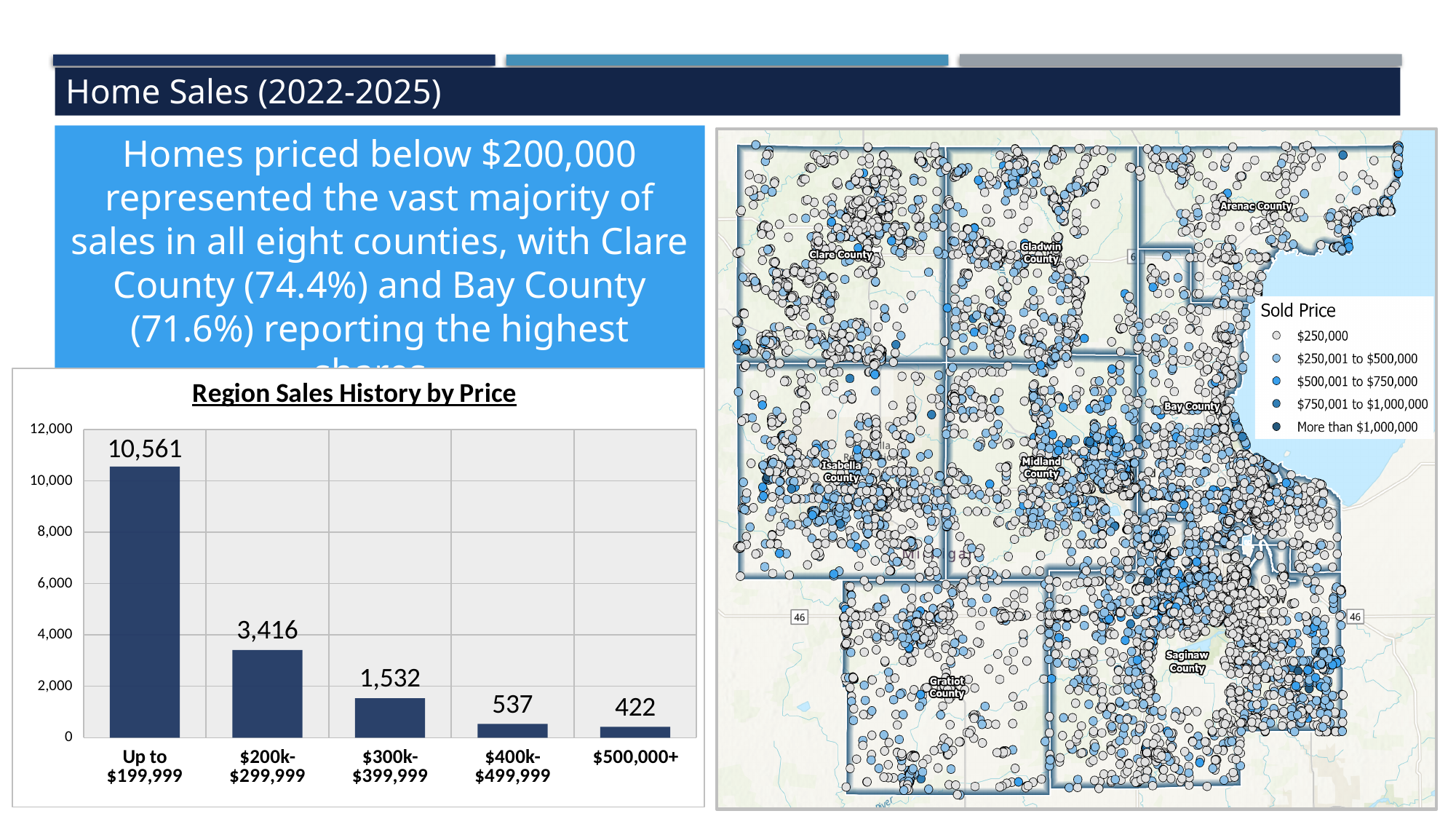
In the Region Sales History by Price chart, what is the value for the $300k-$399,999 range? 1,532 In the Region Sales History by Price chart, how many sales were in the $200k-$299,999 range? 3,416 In the Region Sales History by Price chart, which price range has the lowest number of sales? $500,000+ In the Region Sales History by Price chart, what is the difference between the $400k-$499,999 and $500,000+ values? 115 In the Region Sales History by Price chart, what is the value for the $500,000+ range? 422 In the Region Sales History by Price chart, how many sales were in the Up to $199,999 price range? 10,561 In the Region Sales History by Price chart, what is the difference between the Up to $199,999 and $200k-$299,999 values? 7,145 What type of chart is the Region Sales History by Price chart? Bar chart In the Region Sales History by Price chart, do the values rise or fall as the price ranges increase from left to right? Fall In the Region Sales History by Price chart, which is larger: $300k-$399,999 or $400k-$499,999? $300k-$399,999 In the Region Sales History by Price chart, which price range has the highest number of sales? Up to $199,999 How many price range categories are shown in the Region Sales History by Price chart? 5